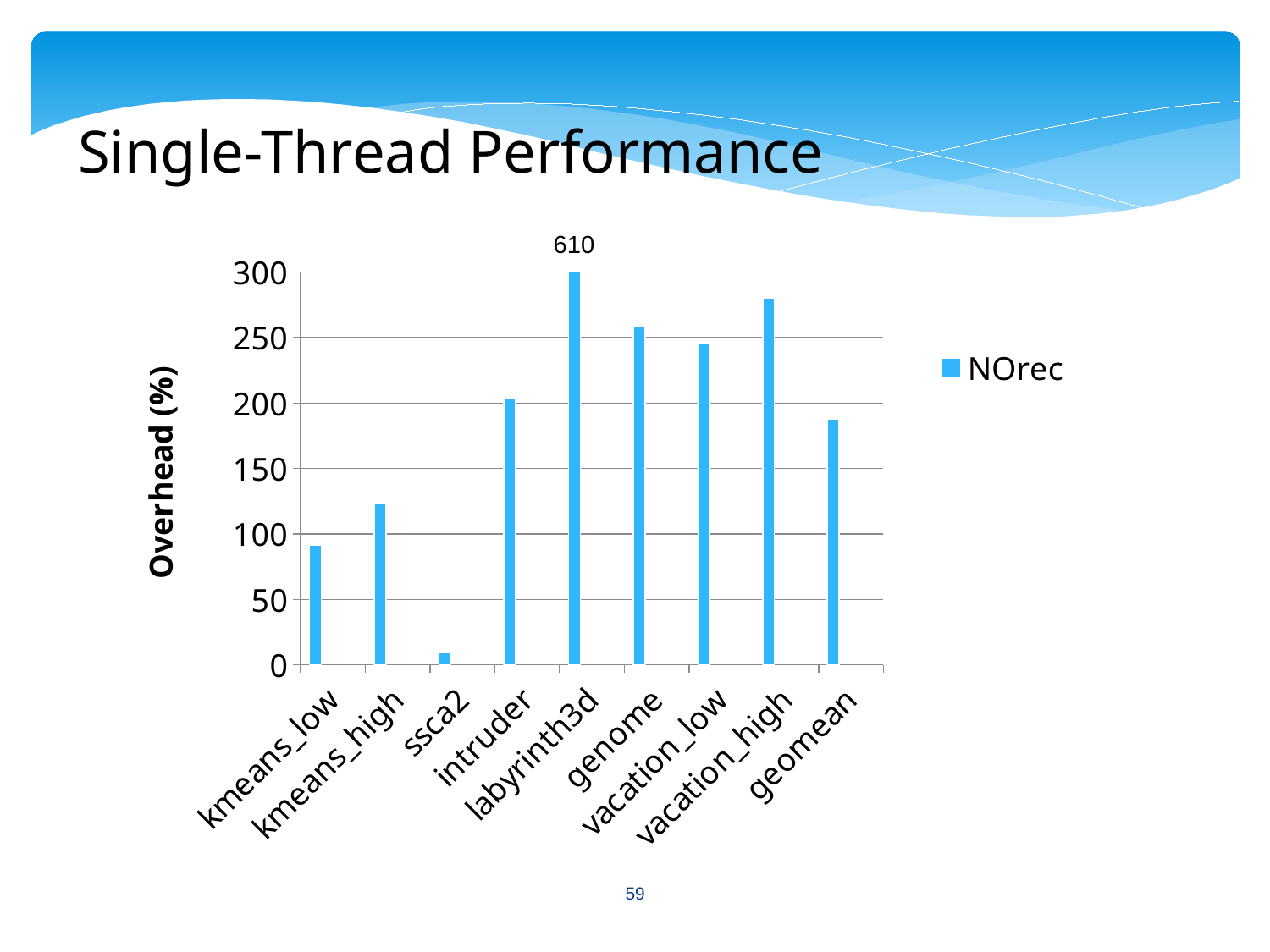
Is the value for vacation_high greater or less than 250? greater What kind of chart is shown on the slide? bar chart Is the value for geomean greater or less than 200? less What is the overhead value printed for labyrinth3d? 610 Which has the larger overhead, kmeans_low or kmeans_high? kmeans_high How many series does the legend list? 1 Which category has the highest overhead? labyrinth3d Is the value for kmeans_high greater or less than 100? greater Which has the larger overhead, vacation_low or vacation_high? vacation_high What is the label on the y axis? Overhead (%) How many categories are plotted along the x axis? 9 Which category has the lowest overhead? ssca2